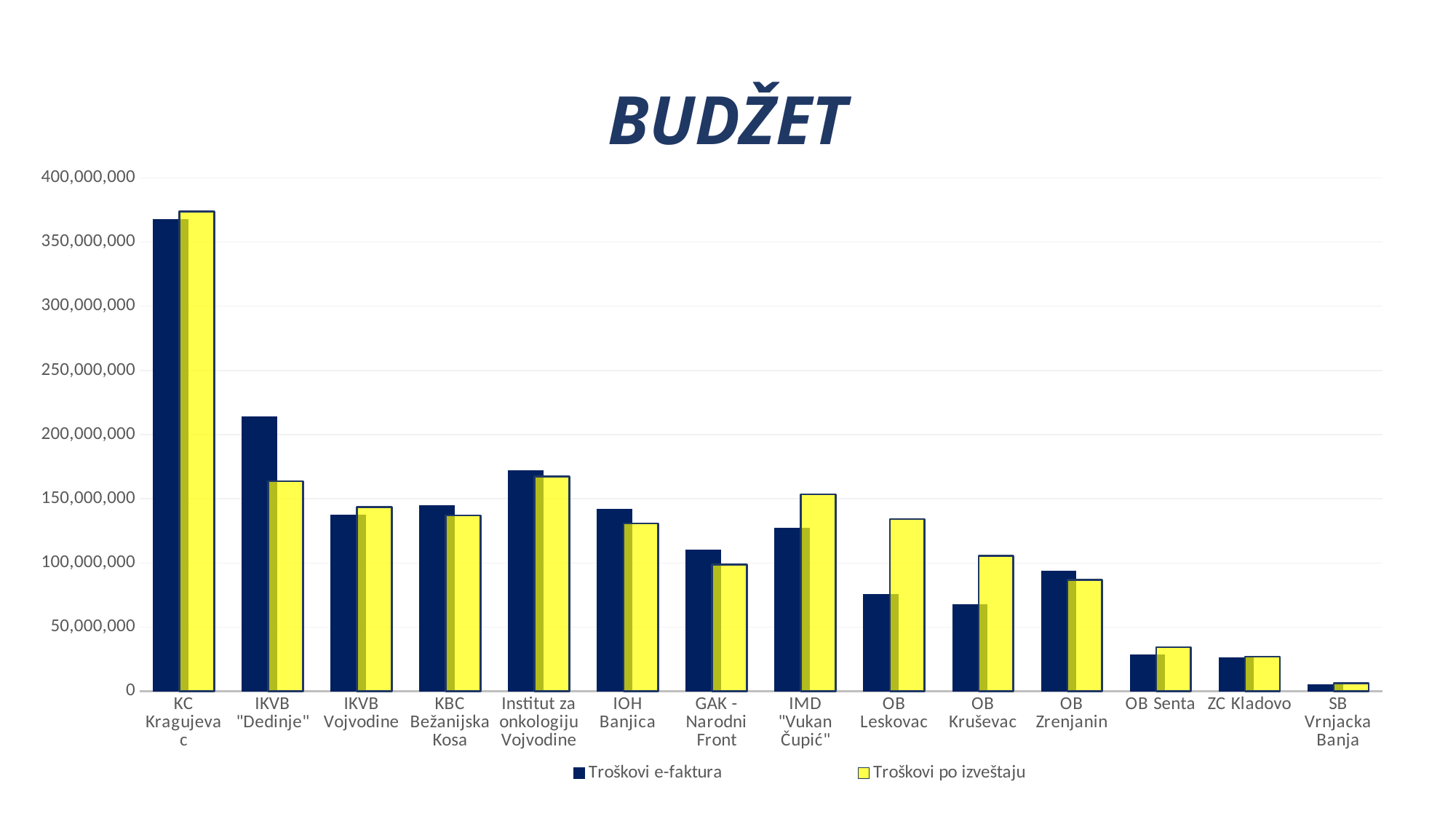
Is the Troškovi e-faktura value for OB Senta greater or less than 50,000,000? less Is the Troškovi e-faktura value for IKVB "Dedinje" greater or less than 200,000,000? greater Is the Troškovi e-faktura value for OB Leskovac greater or less than 100,000,000? less How many series does the legend list? 2 Which institution has the highest value for Troškovi e-faktura? KC Kragujevac How many institutions (categories) are shown on the x axis? 14 What is the title of the chart? BUDŽET Which institution has the lowest value for Troškovi po izveštaju? SB Vrnjacka Banja For OB Leskovac, which series has the larger value: Troškovi e-faktura or Troškovi po izveštaju? Troškovi po izveštaju What kind of chart is shown on the slide? bar chart For IKVB "Dedinje", which series has the larger value: Troškovi e-faktura or Troškovi po izveštaju? Troškovi e-faktura